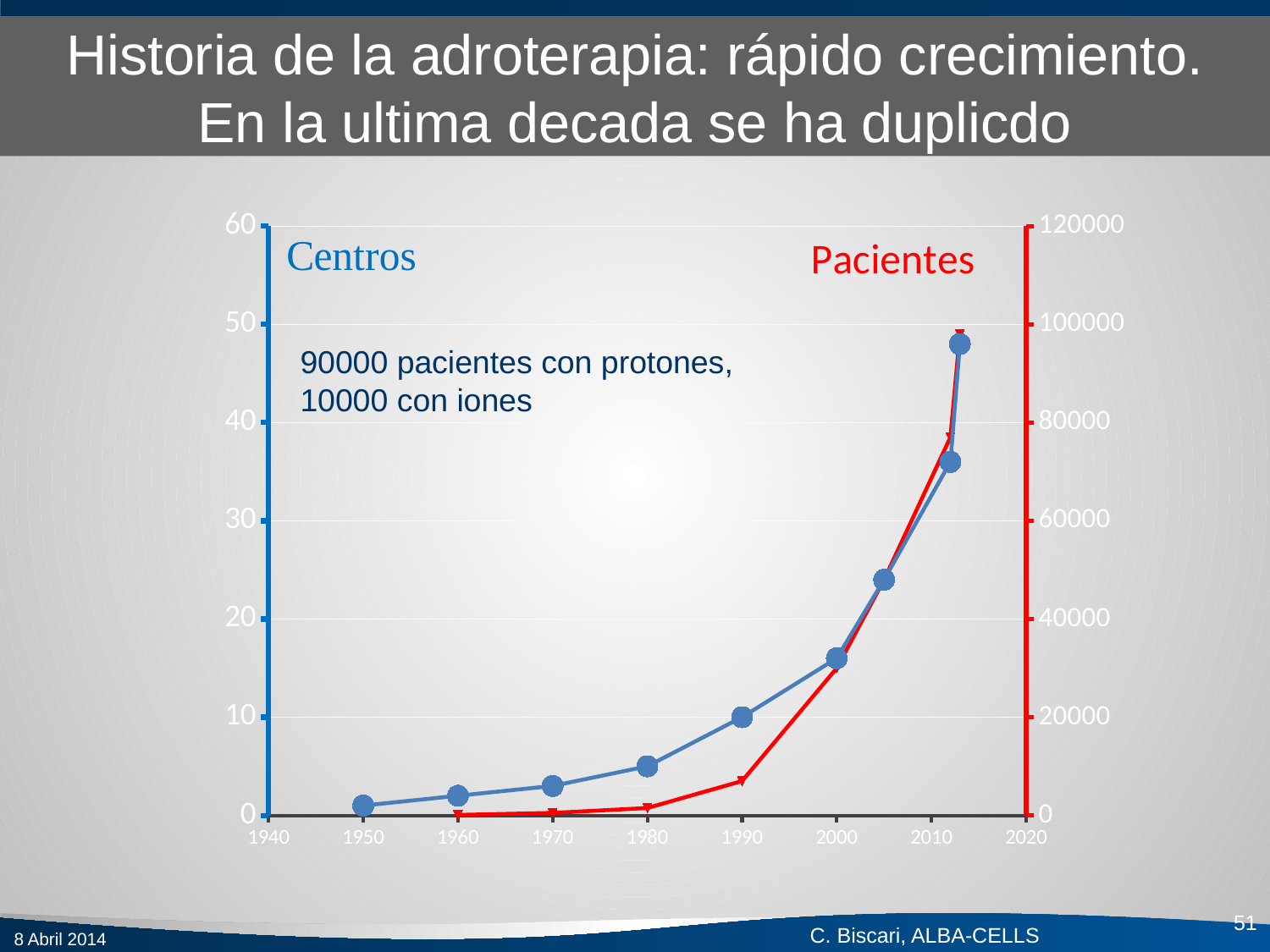
Is the value for Pacientes in 2005 greater or less than 40000? greater Is the value for Centros in 1980 greater or less than 10? less What kind of chart is shown on the slide? line chart What is the top value shown on the right-hand (Pacientes) axis? 120000 Which series is drawn in blue? Centros How many data points are plotted for the Centros series? 9 Is the value for Centros in 2000 greater or less than 10? greater How many series are plotted on the chart? 2 Do the values for Centros rise or fall from 1950 to the most recent point? rise Which is larger for Centros: the value in 1990 or the value in 2005? 2005